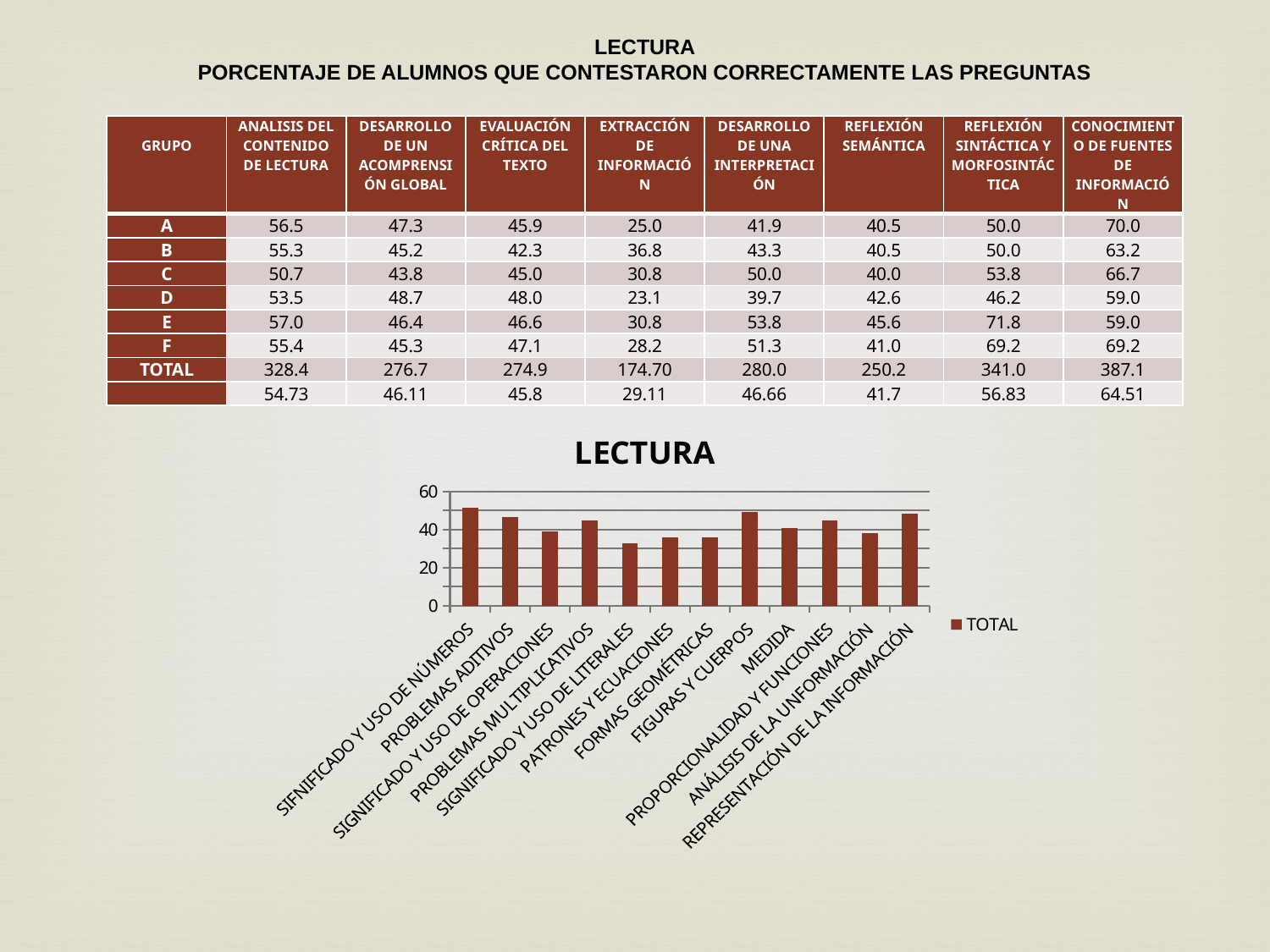
How many series does the chart legend list? 1 What is the title of the chart? LECTURA Is the value for FIGURAS Y CUERPOS greater or less than 60? less Is the value for SIGNIFICADO Y USO DE NÚMEROS greater or less than 40? greater How many categories are plotted along the x axis of the chart? 12 Is the value for PATRONES Y ECUACIONES greater or less than 40? less Which is larger, the value for FIGURAS Y CUERPOS or the value for FORMAS GEOMÉTRICAS? FIGURAS Y CUERPOS Which is larger, the value for SIGNIFICADO Y USO DE NÚMEROS or the value for SIGNIFICADO Y USO DE LITERALES? SIGNIFICADO Y USO DE NÚMEROS What is the name of the series shown in the chart legend? TOTAL What kind of chart is shown on the slide? bar chart